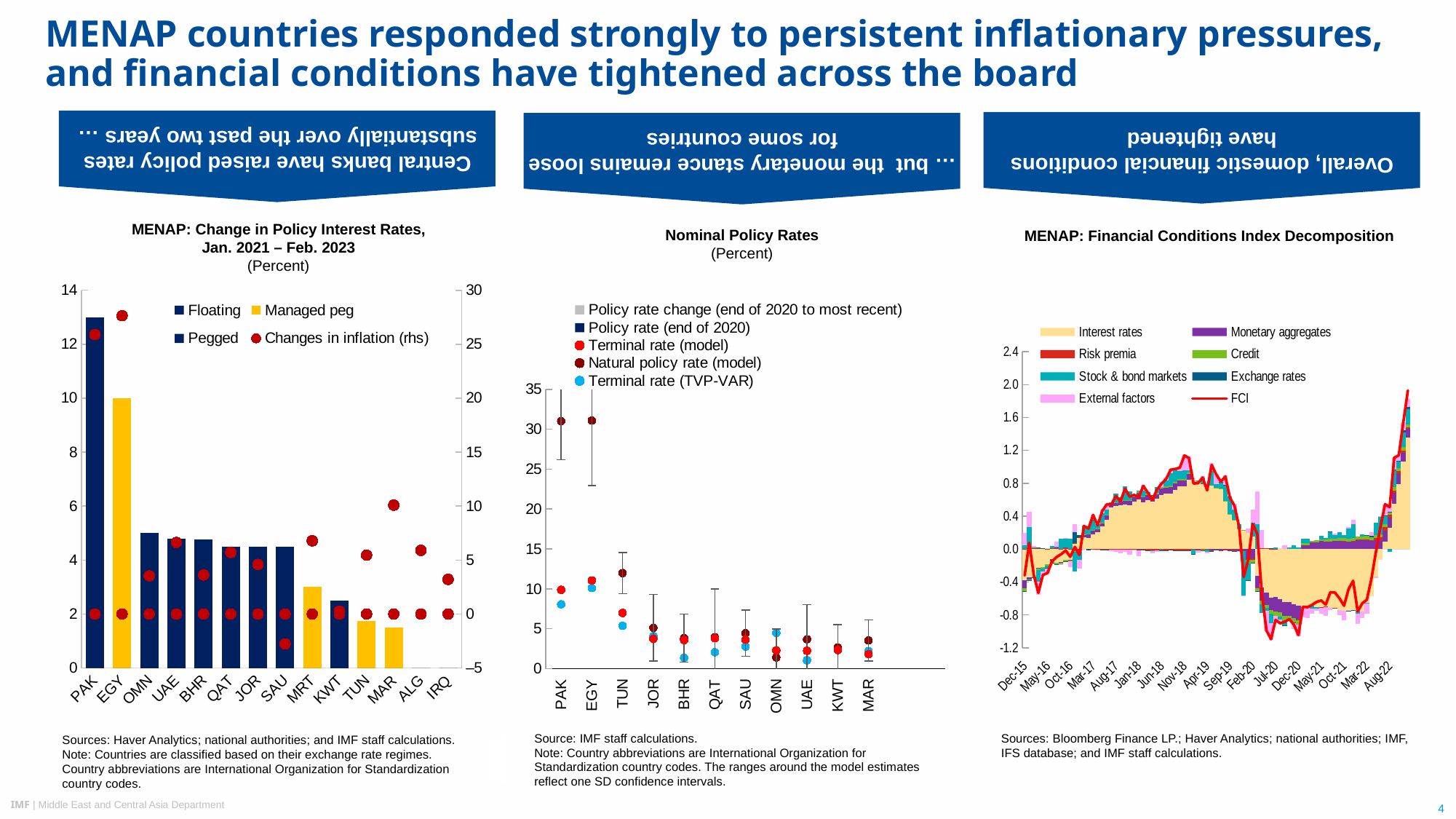
In the 'MENAP: Change in Policy Interest Rates' chart, how many countries are shown on the x axis? 14 In the 'MENAP: Change in Policy Interest Rates' chart, which country has the highest change in policy interest rate? PAK In the 'MENAP: Change in Policy Interest Rates' chart, is the bar for EGY greater or less than 8? greater In the 'Nominal Policy Rates' chart, is the natural policy rate (model) for PAK greater or less than 25? greater How many series does the legend of the 'Nominal Policy Rates' chart list? 5 How many entries does the legend of the 'MENAP: Financial Conditions Index Decomposition' chart list? 8 In the 'Nominal Policy Rates' chart, how many countries are shown on the x axis? 11 How many entries does the legend of the 'MENAP: Change in Policy Interest Rates' chart list? 4 In the 'MENAP: Financial Conditions Index Decomposition' chart, is the FCI line at the end of the series (after Aug-22) greater or less than 1.6? greater In the 'MENAP: Change in Policy Interest Rates' chart, which has the larger bar, OMN or KWT? OMN What kind of chart is 'MENAP: Change in Policy Interest Rates, Jan. 2021 – Feb. 2023'? Bar chart